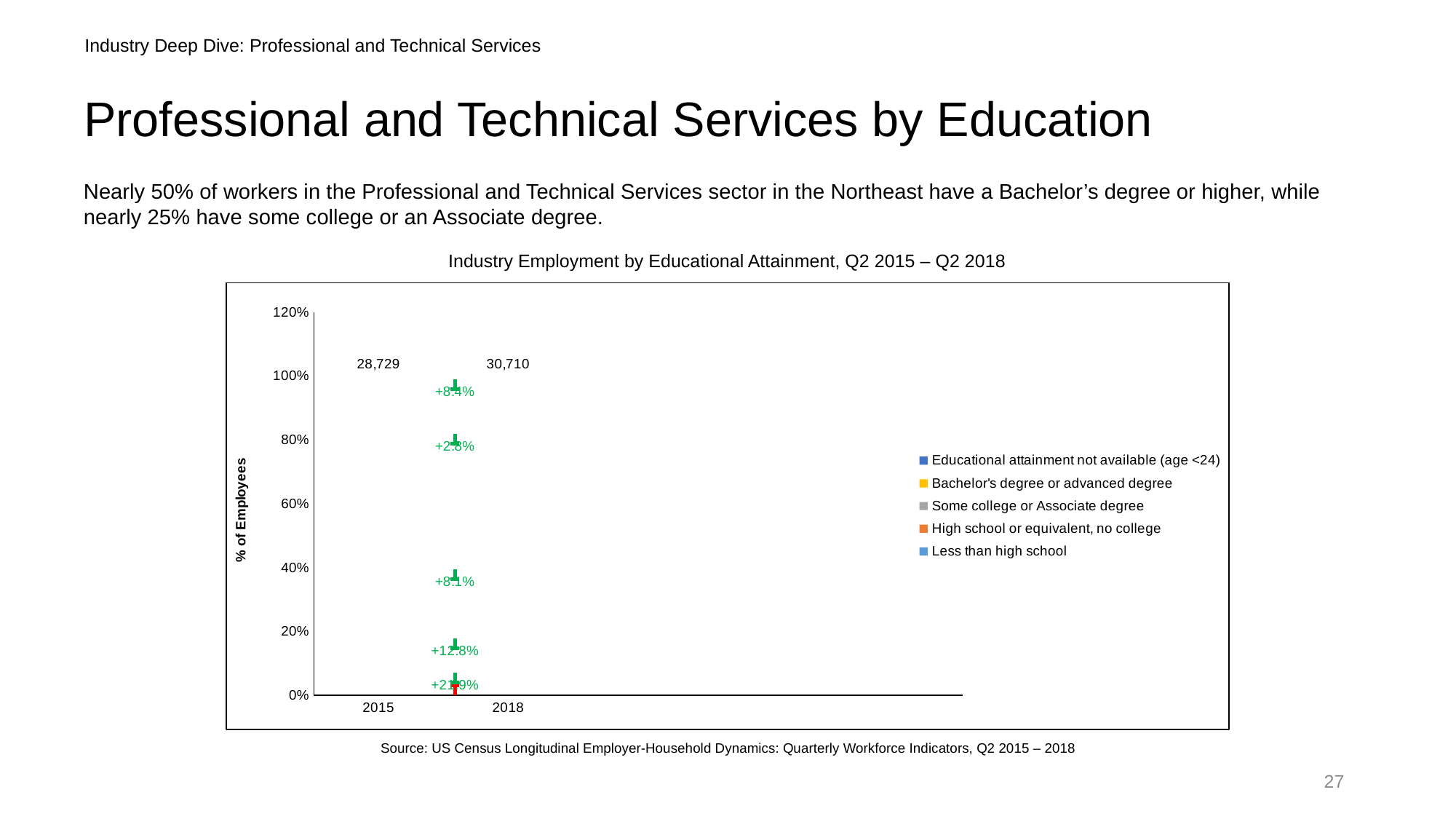
What is the largest green percentage-change label shown on the chart? +21.9% What is the difference between the totals printed for 2018 and 2015? 1,981 What is the label on the y axis? % of Employees What is the title of the chart? Industry Employment by Educational Attainment, Q2 2015 – Q2 2018 What number is printed above the 2015 column? 28,729 What is the smallest green percentage-change label shown on the chart? +2.8% How many categories are shown on the x axis? 2 How many series does the legend list? 5 What number is printed above the 2018 column? 30,710 How many green percentage-change labels are shown between the 2015 and 2018 columns? 5 What is the highest value shown on the y axis? 120% Which year has the larger total printed above it, 2015 or 2018? 2018